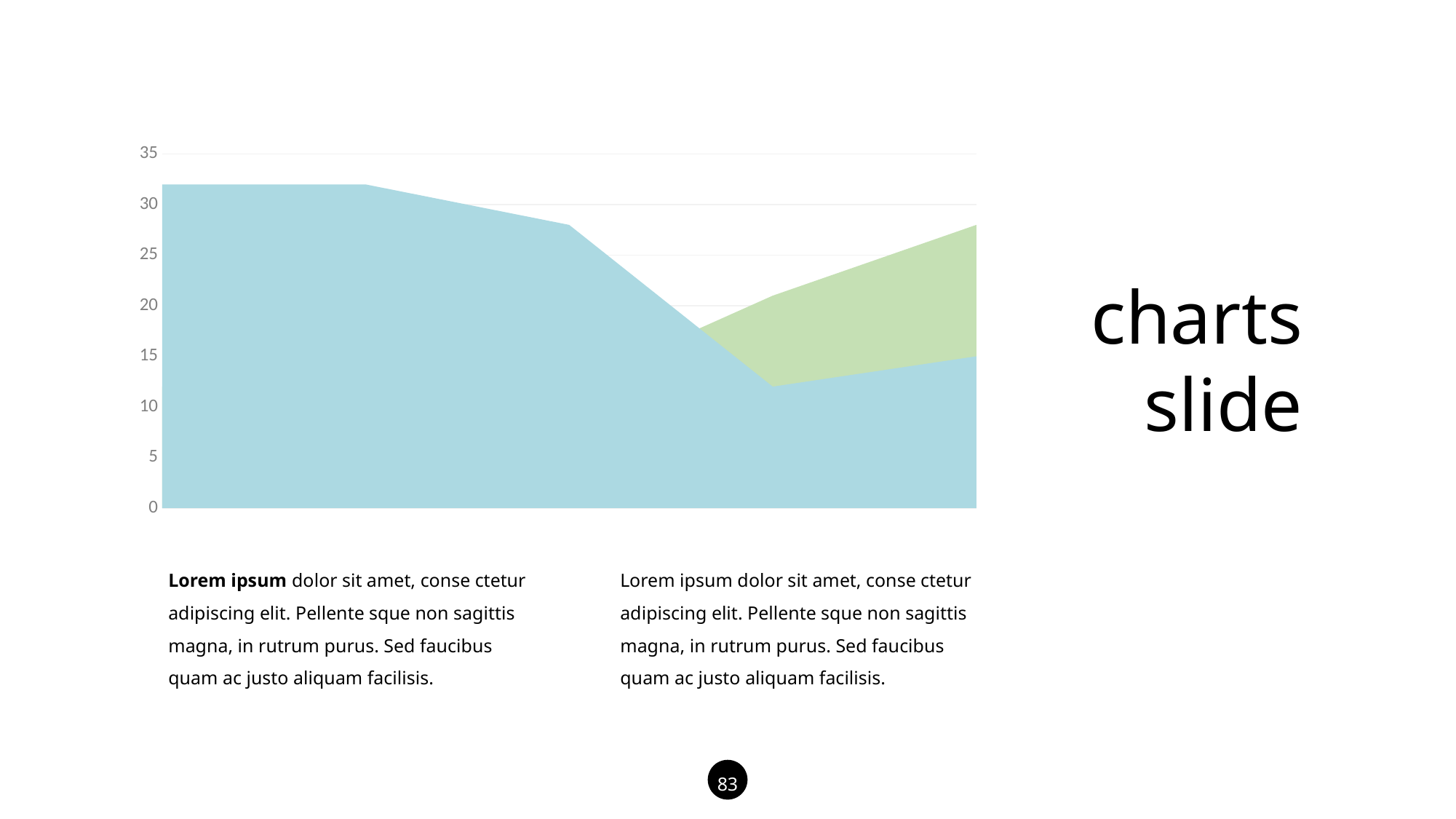
Is the lowest point of the blue area's upper edge greater or less than 15? less Is the value of the blue area at the far left of the chart greater or less than 30? greater What is the highest value shown on the vertical axis? 35 How many coloured areas are plotted in the chart? 2 Does the blue area's upper edge rise or fall overall from left to right? fall Which colour is the area that starts at the left edge of the chart, blue or green? blue Is the top of the green area at the far right of the chart greater or less than 25? greater Does the green area's upper edge rise or fall from left to right? rise What kind of chart is shown on the slide? area chart